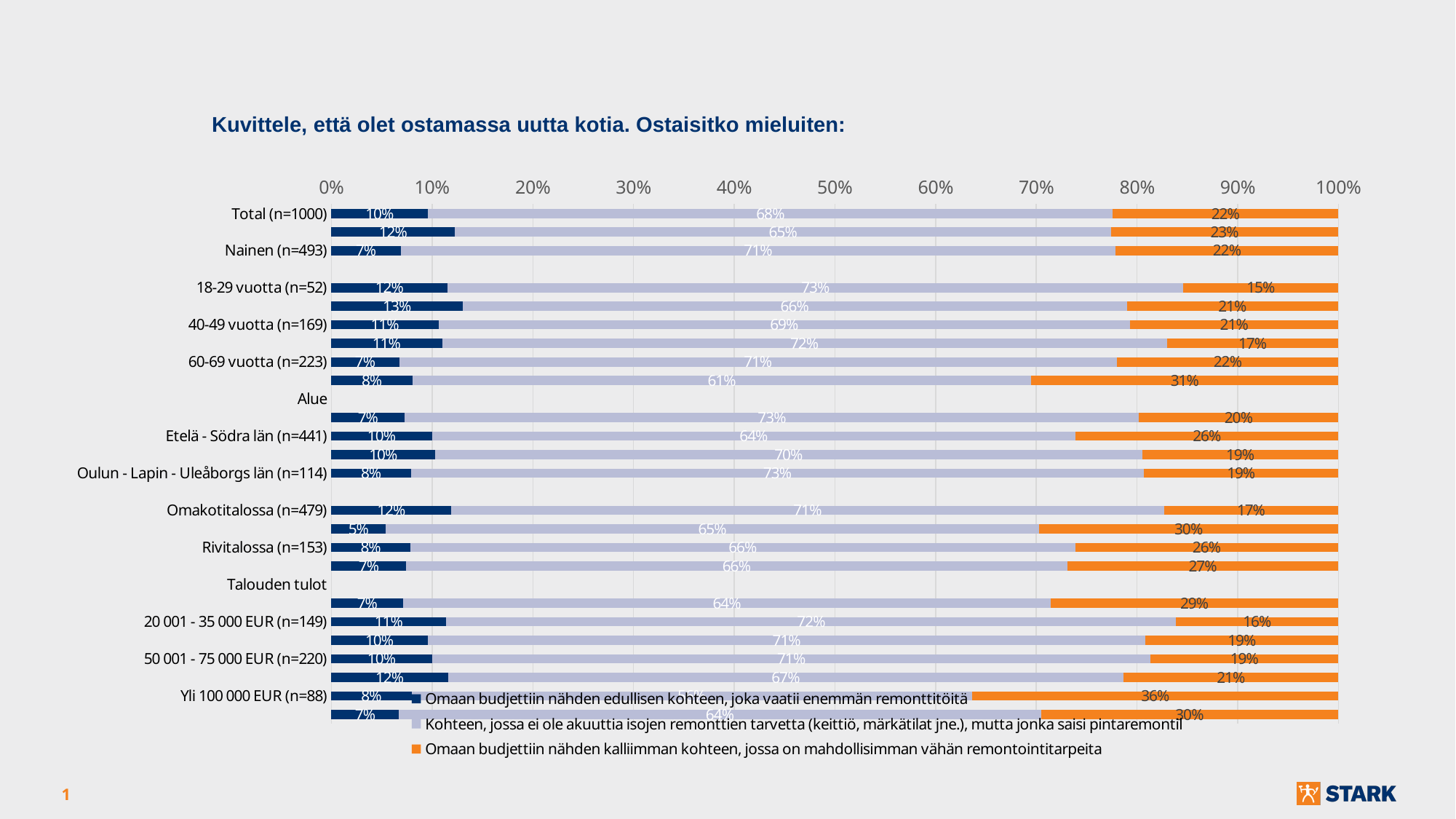
What type of chart is shown on the slide? Stacked bar chart What is the value of the orange series for 60-69 vuotta (n=223)? 22% What is the value of the light blue series (Kohteen, jossa ei ole akuuttia isojen remonttien tarvetta) for 18-29 vuotta (n=52)? 73% Which is larger: the dark blue series value for Omakotitalossa (n=479) or for Rivitalossa (n=153)? Omakotitalossa (n=479) What is the title of the chart? Kuvittele, että olet ostamassa uutta kotia. Ostaisitko mieluiten: What is the value of the dark blue series (Omaan budjettiin nähden edullisen kohteen) for Nainen (n=493)? 7% What is the value of the orange series for Etelä - Södra län (n=441)? 26% What is the value of the light blue series for 20 001 - 35 000 EUR (n=149)? 72% What is the value of the orange series for Yli 100 000 EUR (n=88)? 36% How many series does the legend list? 3 What is the difference between the orange series values for Rivitalossa (n=153) and Omakotitalossa (n=479)? 9 percentage points What is the value of the orange series (Omaan budjettiin nähden kalliimman kohteen) for Total (n=1000)? 22%